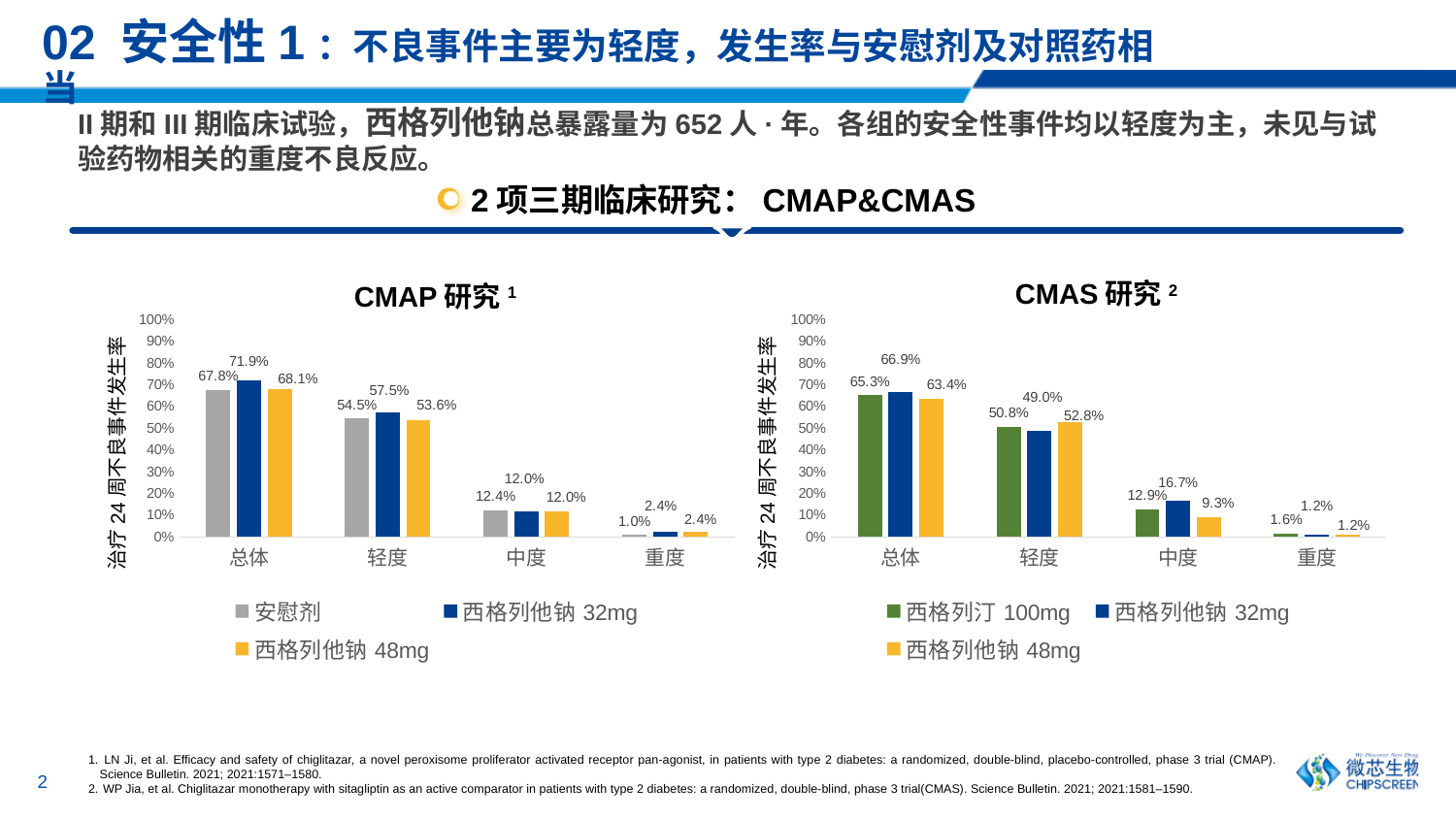
In the CMAP 研究 chart, what is the value for 安慰剂 in the 重度 category? 1.0% In the CMAP 研究 chart, what is the value for 西格列他钠 32mg in the 总体 category? 71.9% In the CMAS 研究 chart, which is larger in the 总体 category: 西格列汀 100mg or 西格列他钠 48mg? 西格列汀 100mg In the CMAS 研究 chart, what is the value for 西格列汀 100mg in the 轻度 category? 50.8% How many series does the legend of the CMAS 研究 chart list? 3 In the CMAS 研究 chart, is the value for 西格列他钠 32mg in the 轻度 category greater or less than 60%? less What kind of chart is the CMAP 研究 chart? bar chart In the CMAP 研究 chart, what is the difference between the 总体 values for 西格列他钠 32mg and 安慰剂? 4.1% In the CMAP 研究 chart, which series has the highest value in the 轻度 category? 西格列他钠 32mg How many categories are shown on the x axis of the CMAP 研究 chart? 4 In the CMAS 研究 chart, what is the value for 西格列他钠 32mg in the 中度 category? 16.7% In the CMAS 研究 chart, which series has the lowest value in the 中度 category? 西格列他钠 48mg